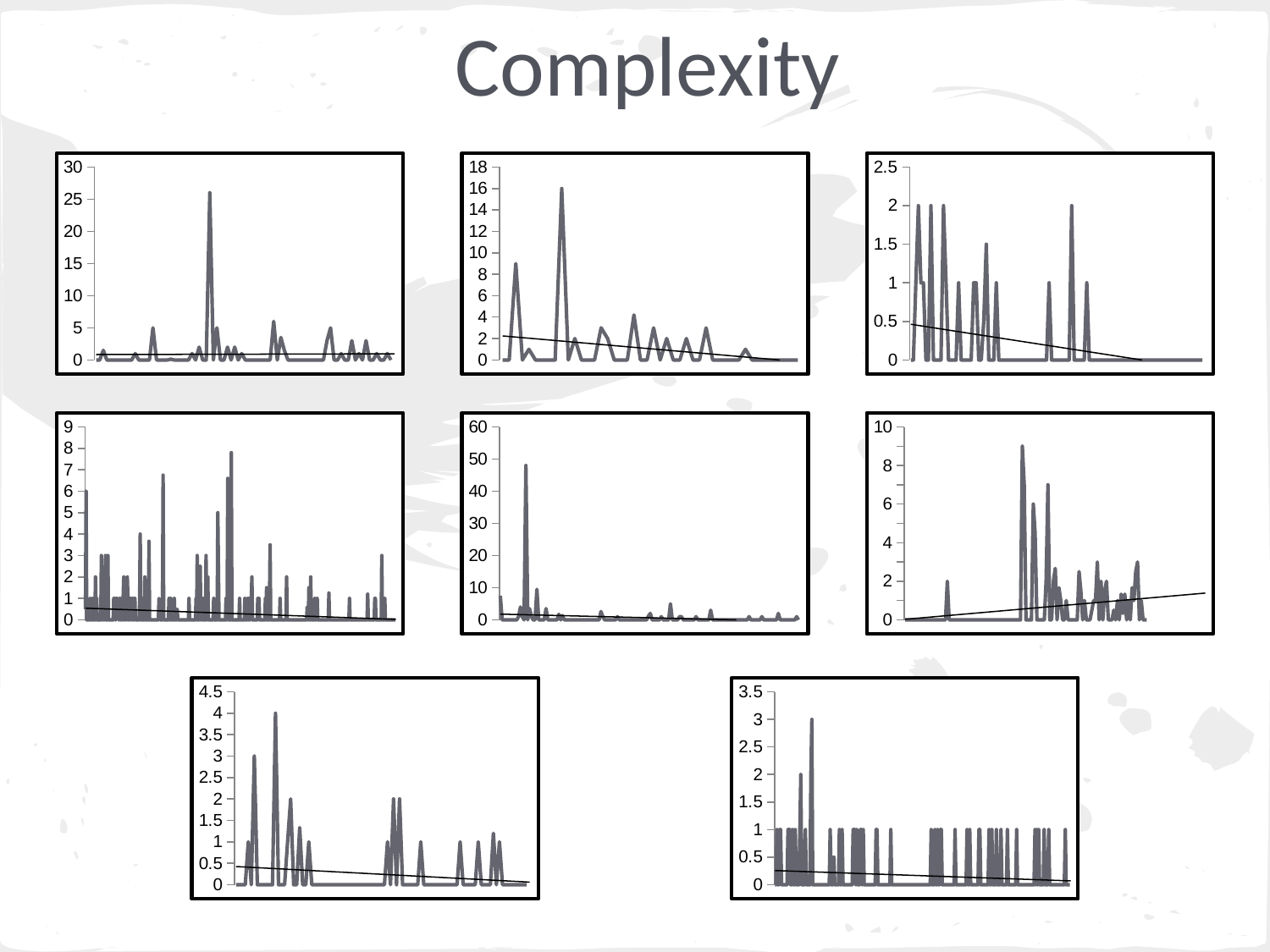
What is the title of the slide containing the charts? Complexity In the top-left chart, is the highest peak greater or less than 20? greater In the top-right chart, what is the highest value reached by the line? 2 In the bottom-right chart, what is the value of the highest peak? 3 How many charts are shown on the slide? 8 In the top-middle chart (y axis up to 18), does the straight trend line rise or fall from left to right? fall In the bottom-left chart, what is the value of the highest peak? 4 In the middle-middle chart (y axis up to 60), is the highest peak greater or less than 40? greater What is the maximum value shown on the y axis of the middle-left chart? 9 What kind of chart is the chart in the top-left corner of the slide? line chart In the middle-right chart (y axis up to 10), does the straight trend line rise or fall from left to right? rise